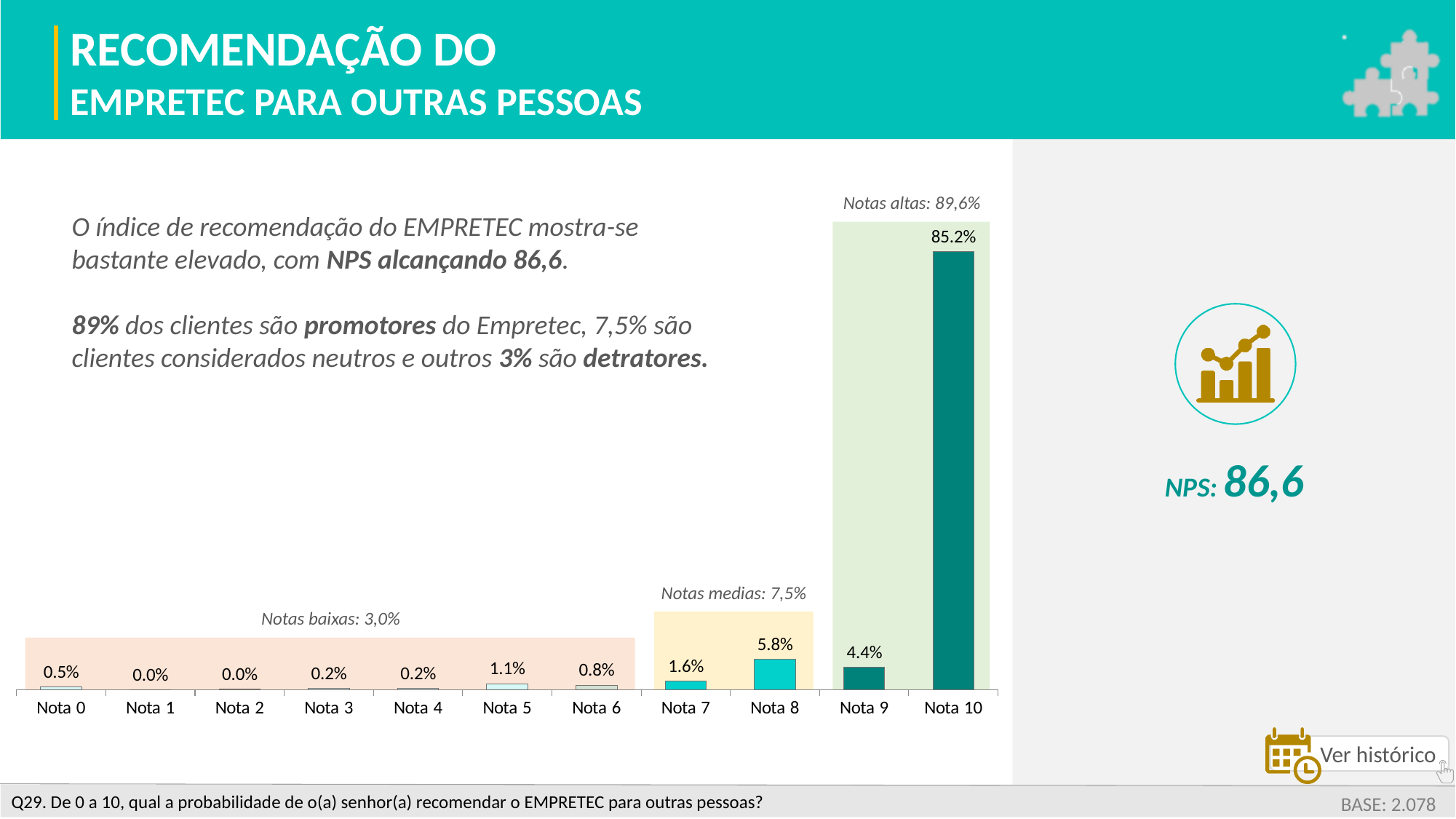
What kind of chart is shown on the slide? bar chart What percentage is shown for the 'Notas altas' group? 89,6% What is the value for Nota 8? 5.8% How many categories are shown on the x axis? 11 Which categories have a value of 0.0%? Nota 1 and Nota 2 Which is larger, the value for Nota 7 or the value for Nota 8? Nota 8 What is the difference between the values for Nota 8 and Nota 7? 4.2% Which category has the highest value? Nota 10 What NPS value is shown on the slide? 86,6 What is the value for Nota 5? 1.1% What is the difference between the values for Nota 10 and Nota 9? 80.8% What is the value for Nota 10? 85.2%